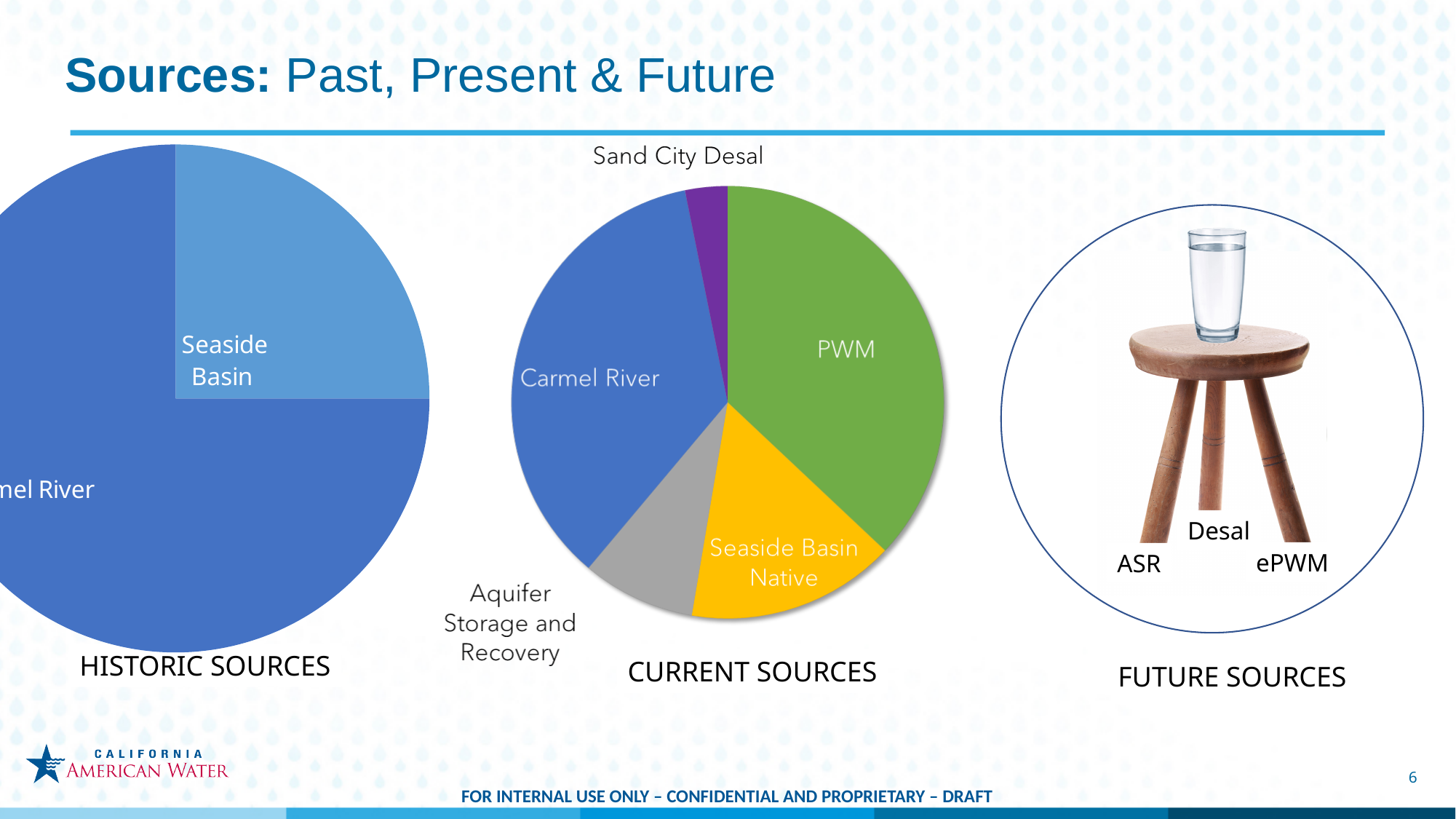
In the CURRENT SOURCES chart, which is larger: PWM or Seaside Basin Native? PWM In the CURRENT SOURCES chart, which source is shown in purple? Sand City Desal In the CURRENT SOURCES chart, which is larger: Seaside Basin Native or Aquifer Storage and Recovery? Seaside Basin Native In the CURRENT SOURCES chart, which source has the smallest slice? Sand City Desal How many slices does the HISTORIC SOURCES pie chart have? 2 In the CURRENT SOURCES chart, what colour is the PWM slice? Green In the HISTORIC SOURCES chart, which source has the largest slice? Carmel River How many slices does the CURRENT SOURCES pie chart have? 5 What kind of chart is the CURRENT SOURCES chart? Pie chart In the HISTORIC SOURCES chart, which source has the smallest slice? Seaside Basin What kind of chart is the HISTORIC SOURCES chart? Pie chart In the CURRENT SOURCES chart, which is larger: Aquifer Storage and Recovery or Sand City Desal? Aquifer Storage and Recovery